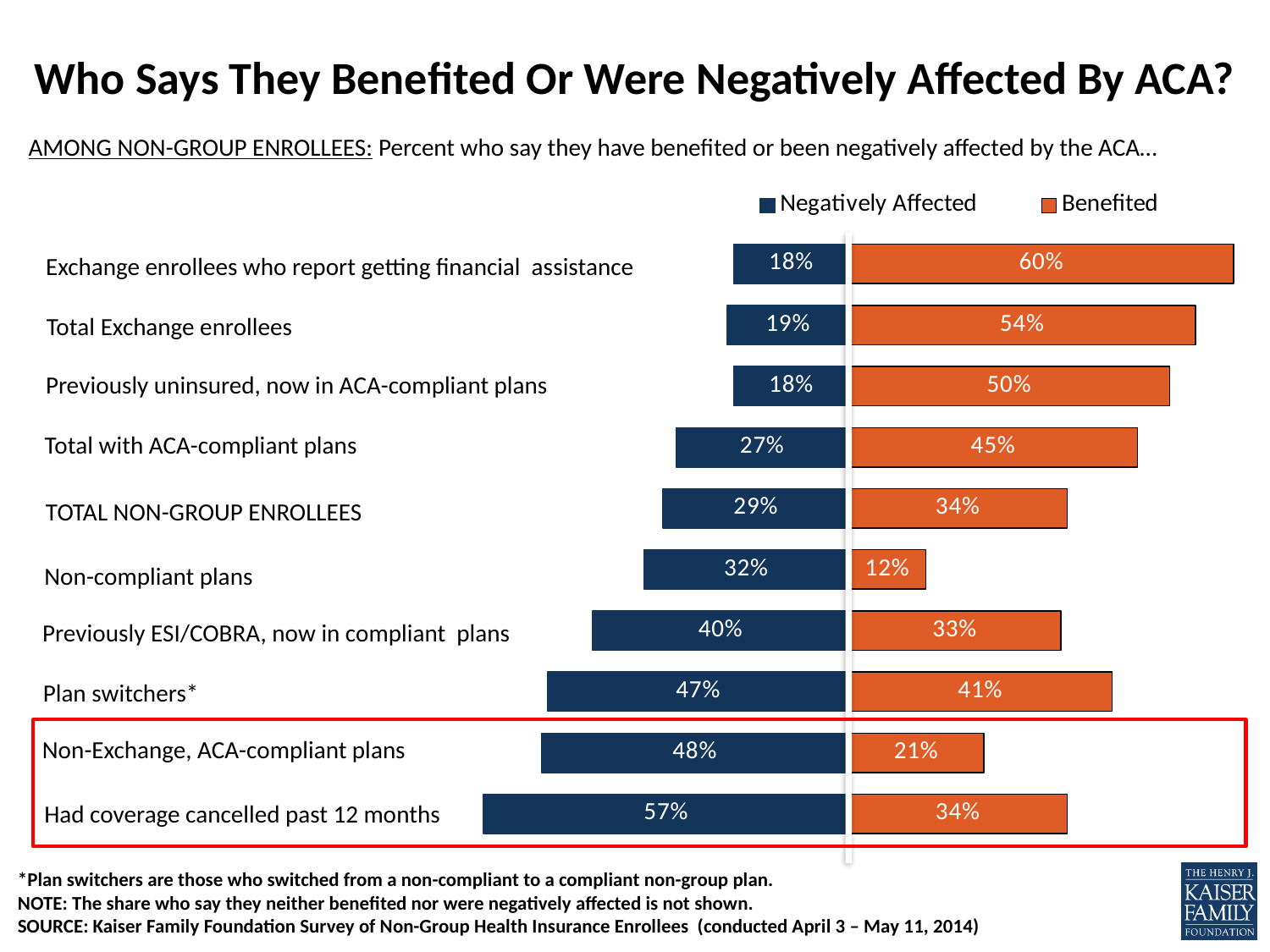
What is the difference between the 'Benefited' and 'Negatively Affected' values for TOTAL NON-GROUP ENROLLEES? 5% Which category has the lowest 'Benefited' value? Non-compliant plans What kind of chart is shown on the slide? Bar chart What is the 'Negatively Affected' value for Total with ACA-compliant plans? 27% How many series does the legend list? 2 What percent of Non-compliant plans enrollees say they benefited? 12% For Plan switchers*, which is larger: the 'Negatively Affected' value or the 'Benefited' value? Negatively Affected Which category has the highest 'Negatively Affected' value? Had coverage cancelled past 12 months What percent of those who had coverage cancelled in the past 12 months say they were negatively affected by the ACA? 57% What percent of Exchange enrollees who report getting financial assistance say they benefited from the ACA? 60% Which colour represents the 'Benefited' series in the chart? Orange How many categories are shown in the chart? 10